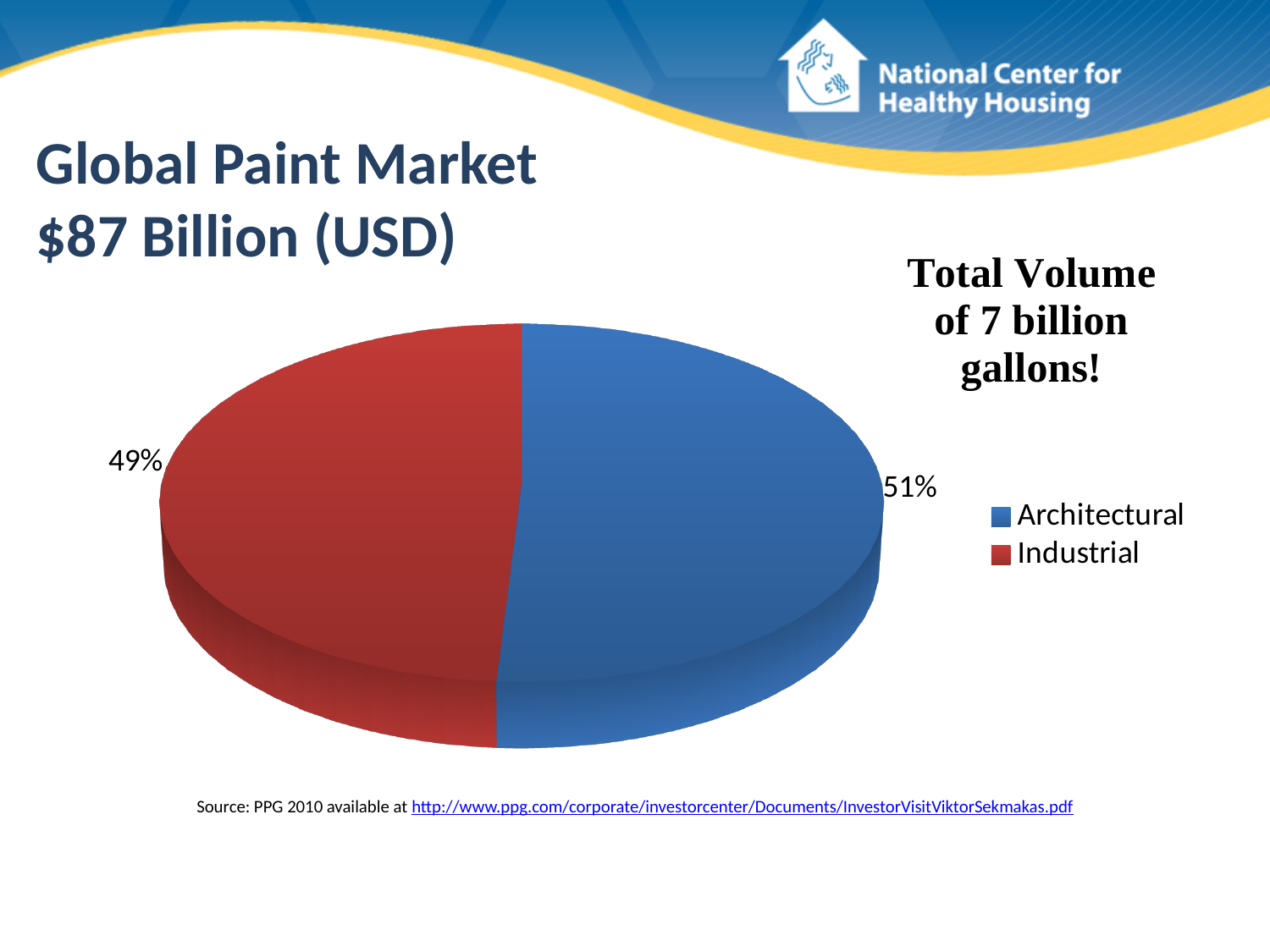
How many slices does the pie chart have? 2 What share of the pie does the Architectural slice represent? 51% Which is larger, the Architectural share or the Industrial share? Architectural Which slice of the pie is the largest? Architectural What is the difference in percentage points between the Architectural and Industrial shares? 2 percentage points How many entries does the legend list? 2 What colour is the Industrial slice in the pie chart? Red Which slice of the pie is the smallest? Industrial What kind of chart is shown on the slide? Pie chart What is the title of the slide containing the pie chart? Global Paint Market $87 Billion (USD) What share of the pie does the Industrial slice represent? 49%